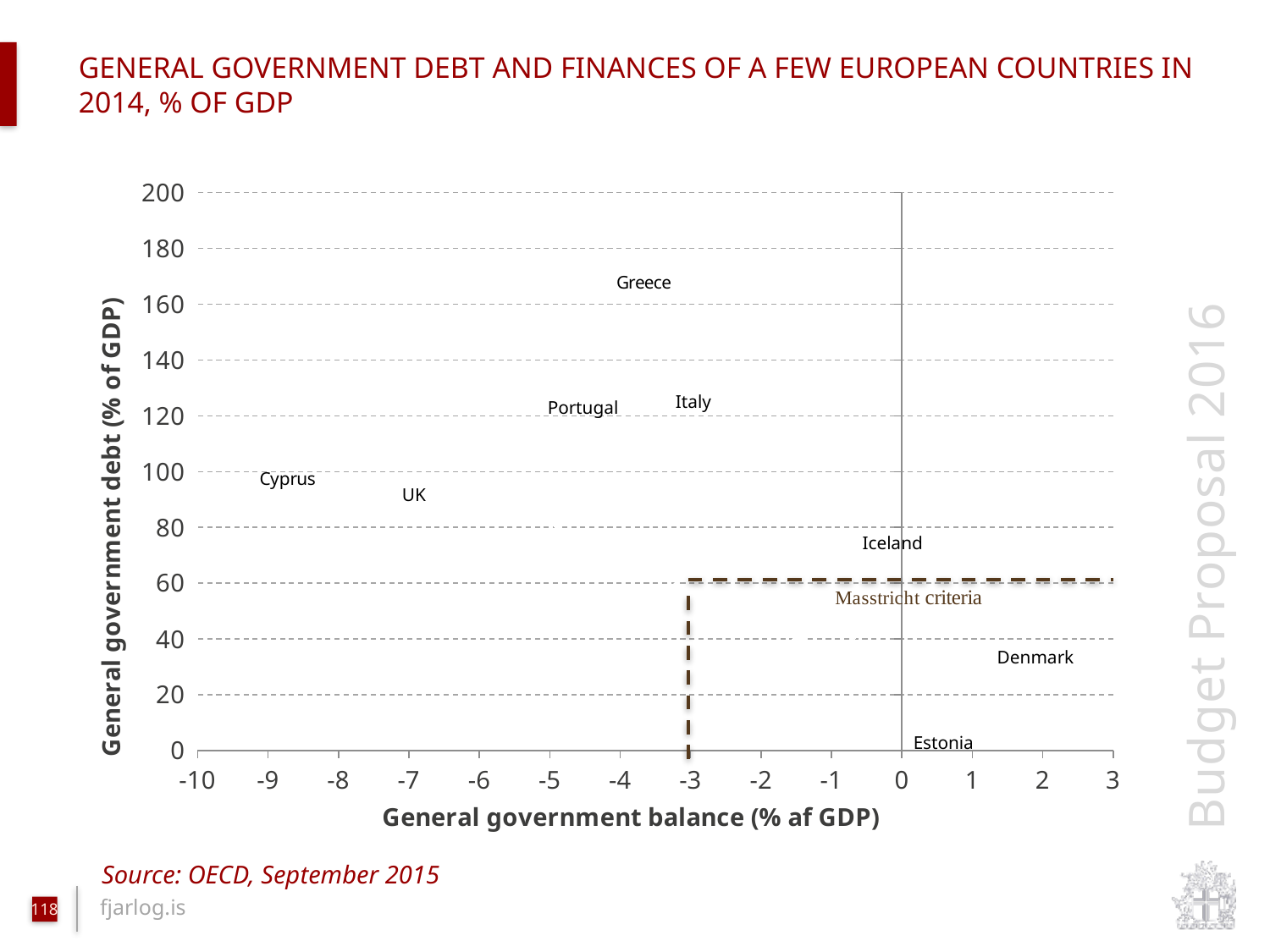
Is the general government debt for Estonia greater or less than 20? less What kind of chart is shown on the slide? scatter chart Which country has the lowest general government debt (% of GDP)? Estonia Is the general government balance for Cyprus greater or less than -5? less Which country has the most negative general government balance (% of GDP)? Cyprus Is the general government debt for Iceland greater or less than 60? greater Which country has the higher general government debt, Greece or Denmark? Greece How many countries are plotted on the chart? 8 Which country has the higher general government balance, Denmark or Cyprus? Denmark What is the title of the x axis of the chart? General government balance (% af GDP) Which country has the highest general government debt (% of GDP)? Greece